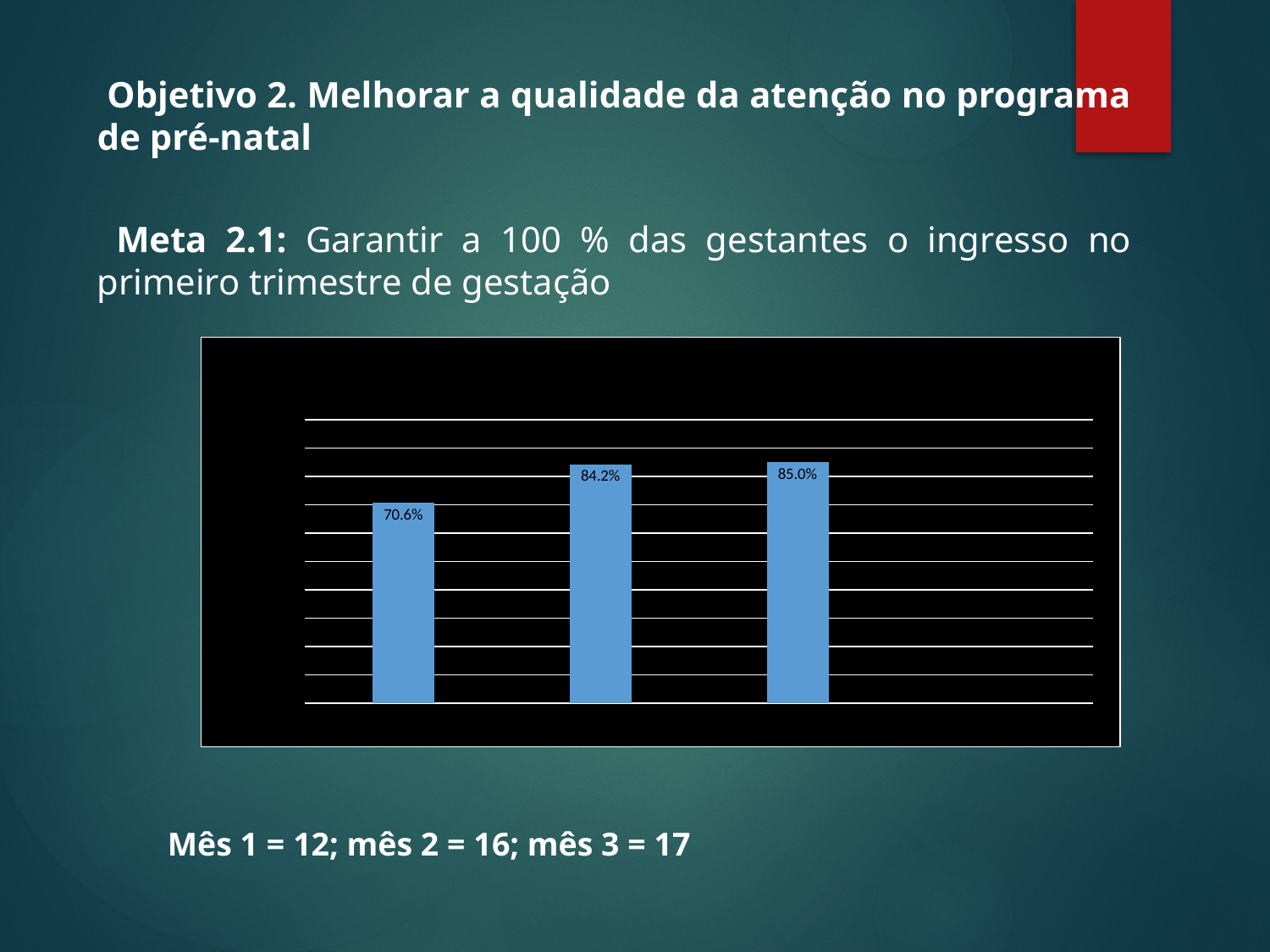
Do the values rise or fall from left to right across the bars? Rise What colour are the bars in the chart? Blue What value is shown on the first (leftmost) bar of the chart? 70.6% Which bar has the highest value in the chart? The third (rightmost) bar, 85.0% What value is shown on the second (middle) bar of the chart? 84.2% What kind of chart is shown on the slide? Bar chart How many bars are plotted in the chart? 3 What is the difference between the values of the second bar and the first bar? 13.6% What value is shown on the third (rightmost) bar of the chart? 85.0% Which bar has the lowest value in the chart? The first (leftmost) bar, 70.6% Which is larger, the value of the first bar or the value of the second bar? The second bar (84.2%) What is the difference between the values of the third bar and the first bar? 14.4%